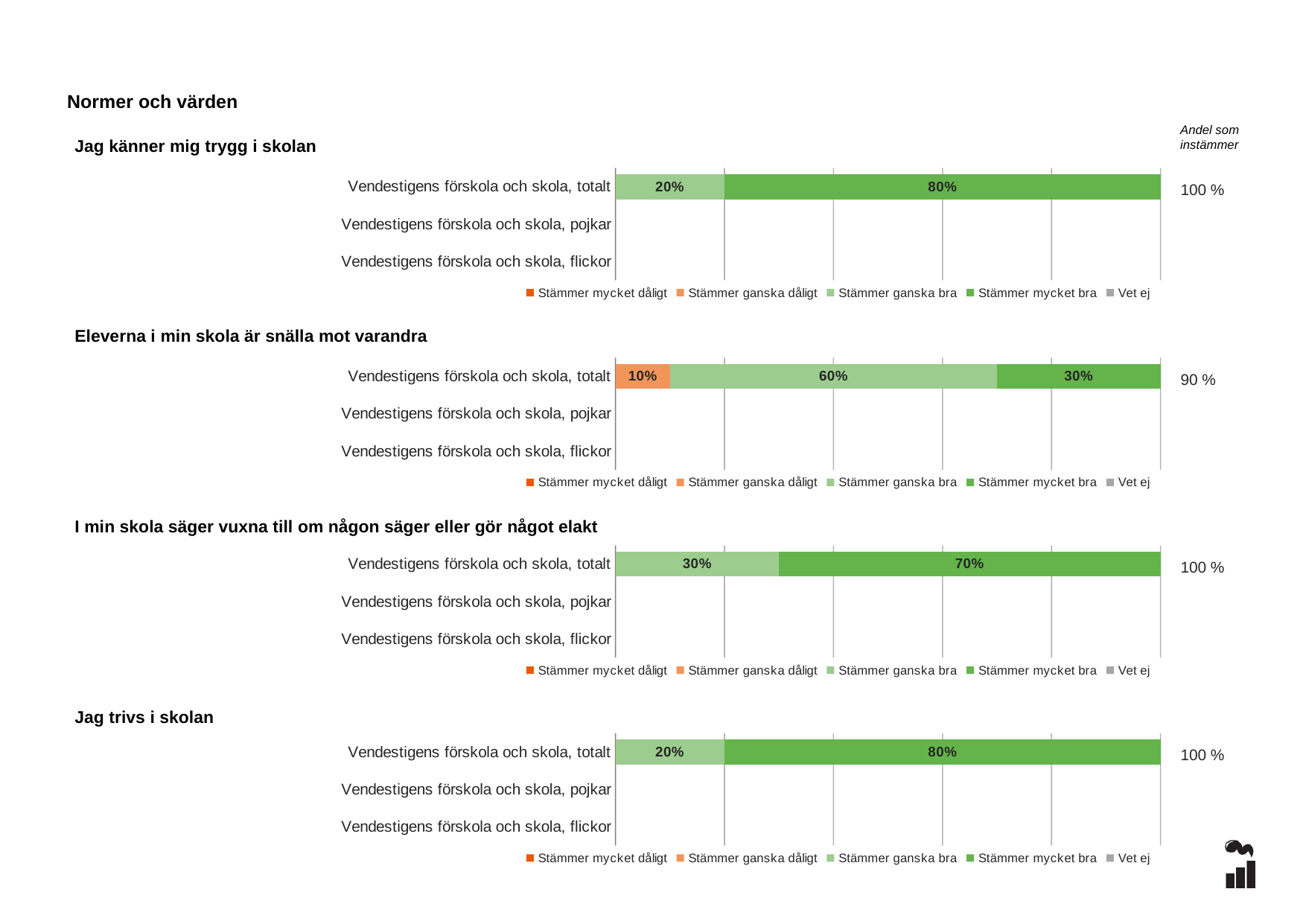
In the chart 'Eleverna i min skola är snälla mot varandra', what is the total of the 'Stämmer ganska bra' and 'Stämmer mycket bra' segments for Vendestigens förskola och skola, totalt? 90% In the chart 'Eleverna i min skola är snälla mot varandra', which series has the largest share for Vendestigens förskola och skola, totalt? Stämmer ganska bra In the chart 'Eleverna i min skola är snälla mot varandra', what is the value for 'Stämmer ganska dåligt' for Vendestigens förskola och skola, totalt? 10% In the chart 'Jag trivs i skolan', which is larger for Vendestigens förskola och skola, totalt: 'Stämmer ganska bra' or 'Stämmer mycket bra'? Stämmer mycket bra In the chart 'I min skola säger vuxna till om någon säger eller gör något elakt', what is the difference between 'Stämmer mycket bra' and 'Stämmer ganska bra' for Vendestigens förskola och skola, totalt? 40% How many categories are shown on the y axis of the chart 'Jag känner mig trygg i skolan'? 3 In the chart 'Jag känner mig trygg i skolan', what is the value for 'Stämmer mycket bra' for Vendestigens förskola och skola, totalt? 80% In the chart 'Eleverna i min skola är snälla mot varandra', what is the value for 'Stämmer ganska bra' for Vendestigens förskola och skola, totalt? 60% What kind of chart is 'Jag trivs i skolan'? Stacked bar chart In the chart 'I min skola säger vuxna till om någon säger eller gör något elakt', what is the value for 'Stämmer mycket bra' for Vendestigens förskola och skola, totalt? 70% In the chart 'Jag känner mig trygg i skolan', what is the value for 'Stämmer ganska bra' for Vendestigens förskola och skola, totalt? 20% How many series does the legend list in the chart 'Jag trivs i skolan'? 5